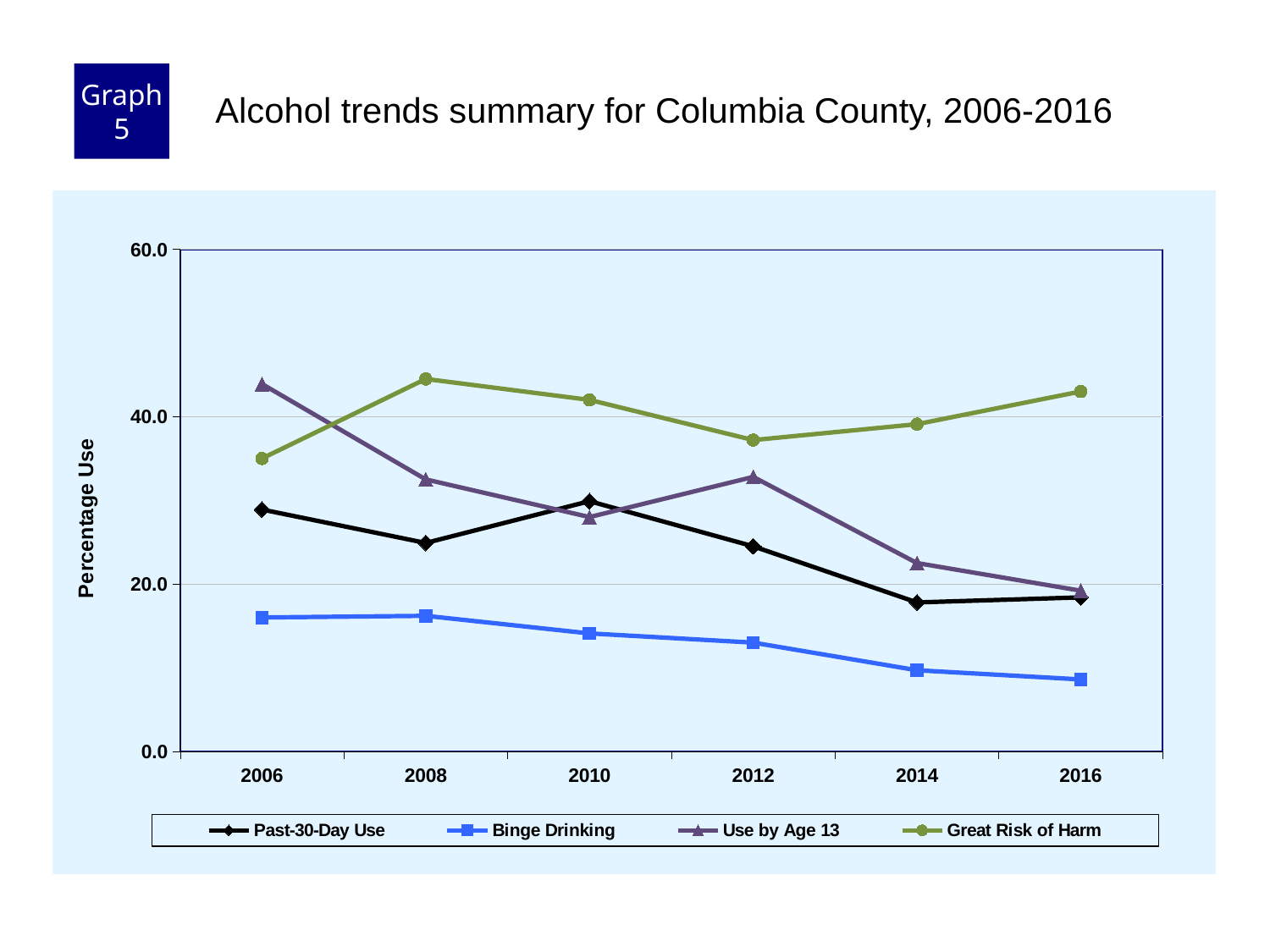
What kind of chart is shown on the slide? Line chart Which series has the lowest value in 2012? Binge Drinking In 2006, which is larger: Use by Age 13 or Great Risk of Harm? Use by Age 13 How many series does the legend list? 4 Which series has the highest value in 2016? Great Risk of Harm Does the Binge Drinking line rise or fall from 2006 to 2016? Fall Is the value for Past-30-Day Use in 2014 greater or less than 20.0? less Is the value for Binge Drinking in 2006 greater or less than 20.0? less Is the value for Great Risk of Harm in 2008 greater or less than 40.0? greater What is the label on the y axis? Percentage Use How many years are plotted along the x axis? 6